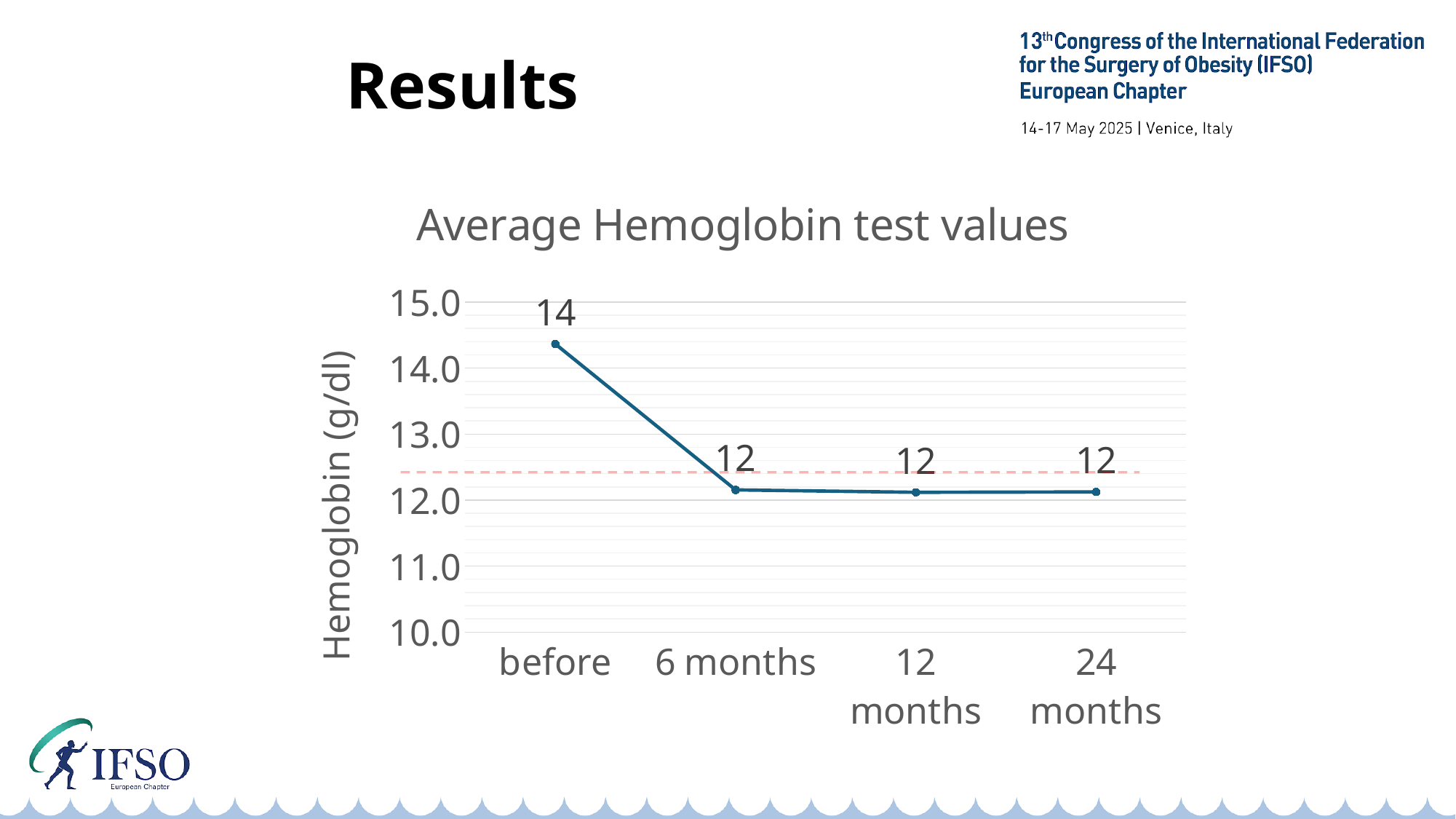
Which time point has the highest average hemoglobin value? before What is the average hemoglobin value labelled at 24 months? 12 How many time points are plotted on the chart? 4 Do the hemoglobin values rise or fall from 'before' to 6 months? fall What is the average hemoglobin value labelled at 6 months? 12 Which is larger, the hemoglobin value at 'before' or at 12 months? before Is the value for 6 months greater or less than 13.0? less What is the label on the vertical axis of the chart? Hemoglobin (g/dl) What is the average hemoglobin value labelled for the 'before' time point? 14 Is the value for 'before' greater or less than 13.0? greater What is the difference between the labelled hemoglobin values at 'before' and at 6 months? 2 What kind of chart is shown on the slide? line chart